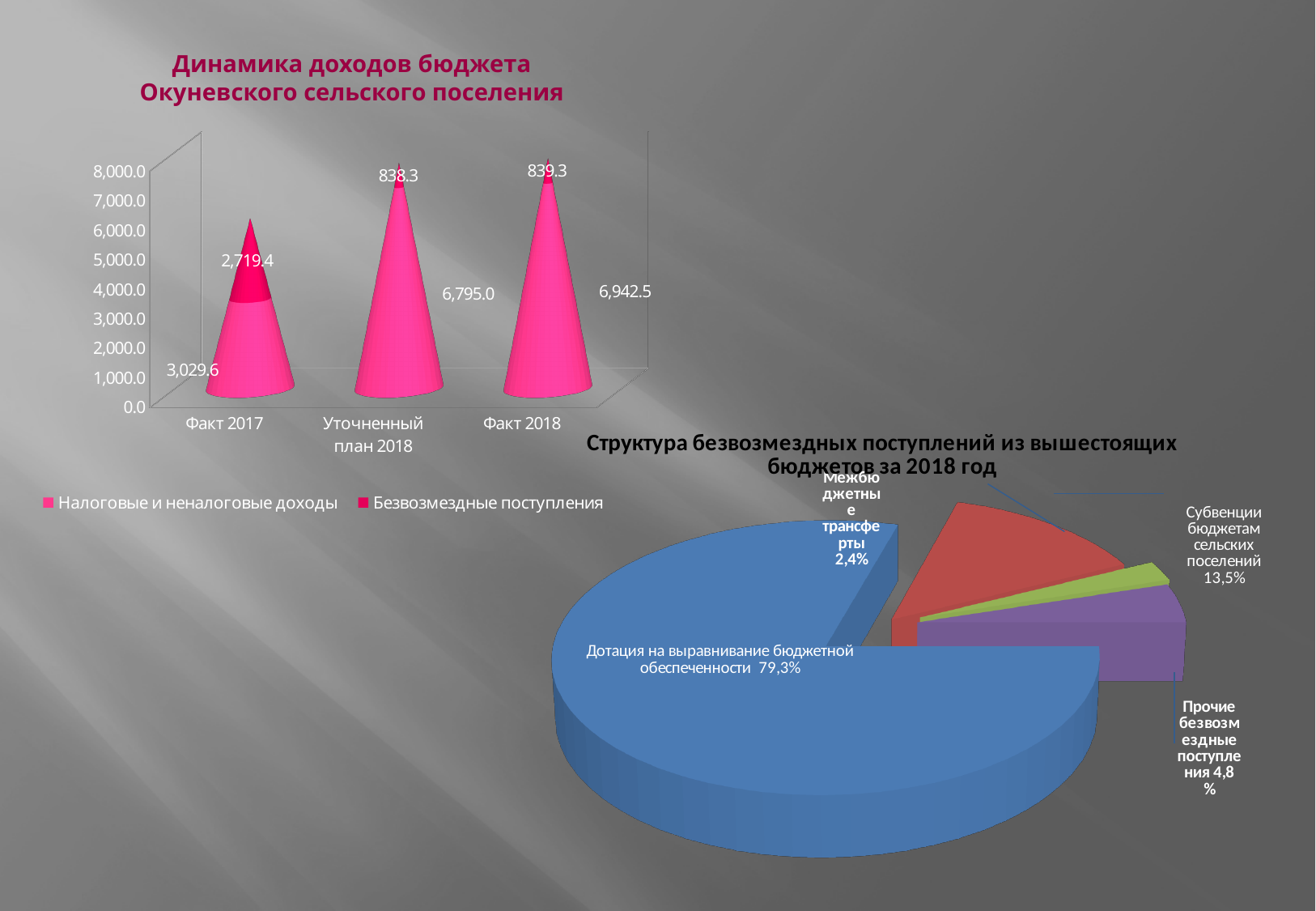
In the chart 'Динамика доходов бюджета Окуневского сельского поселения', which category has the highest value of 'Безвозмездные поступления'? Факт 2017 In the chart 'Динамика доходов бюджета Окуневского сельского поселения', what is the value of 'Безвозмездные поступления' for 'Уточненный план 2018'? 838.3 In the chart 'Структура безвозмездных поступлений из вышестоящих бюджетов за 2018 год', what share does 'Дотация на выравнивание бюджетной обеспеченности' have? 79,3% In the chart 'Динамика доходов бюджета Окуневского сельского поселения', does 'Налоговые и неналоговые доходы' rise or fall from 'Факт 2017' to 'Факт 2018'? rise In the chart 'Динамика доходов бюджета Окуневского сельского поселения', what is the difference between 'Налоговые и неналоговые доходы' for 'Факт 2018' and for 'Уточненный план 2018'? 147.5 In the chart 'Динамика доходов бюджета Окуневского сельского поселения', how many categories are shown on the x axis? 3 In the chart 'Динамика доходов бюджета Окуневского сельского поселения', what is the value of 'Налоговые и неналоговые доходы' for 'Факт 2017'? 3,029.6 In the chart 'Динамика доходов бюджета Окуневского сельского поселения', how many series does the legend list? 2 In the chart 'Структура безвозмездных поступлений из вышестоящих бюджетов за 2018 год', which slice is the smallest? Межбюджетные трансферты What kind of chart is 'Структура безвозмездных поступлений из вышестоящих бюджетов за 2018 год'? pie chart In the chart 'Динамика доходов бюджета Окуневского сельского поселения', what is the total of the stacked bar for 'Факт 2017'? 5,749.0 In the chart 'Динамика доходов бюджета Окуневского сельского поселения', what is the value of 'Налоговые и неналоговые доходы' for 'Факт 2018'? 6,942.5